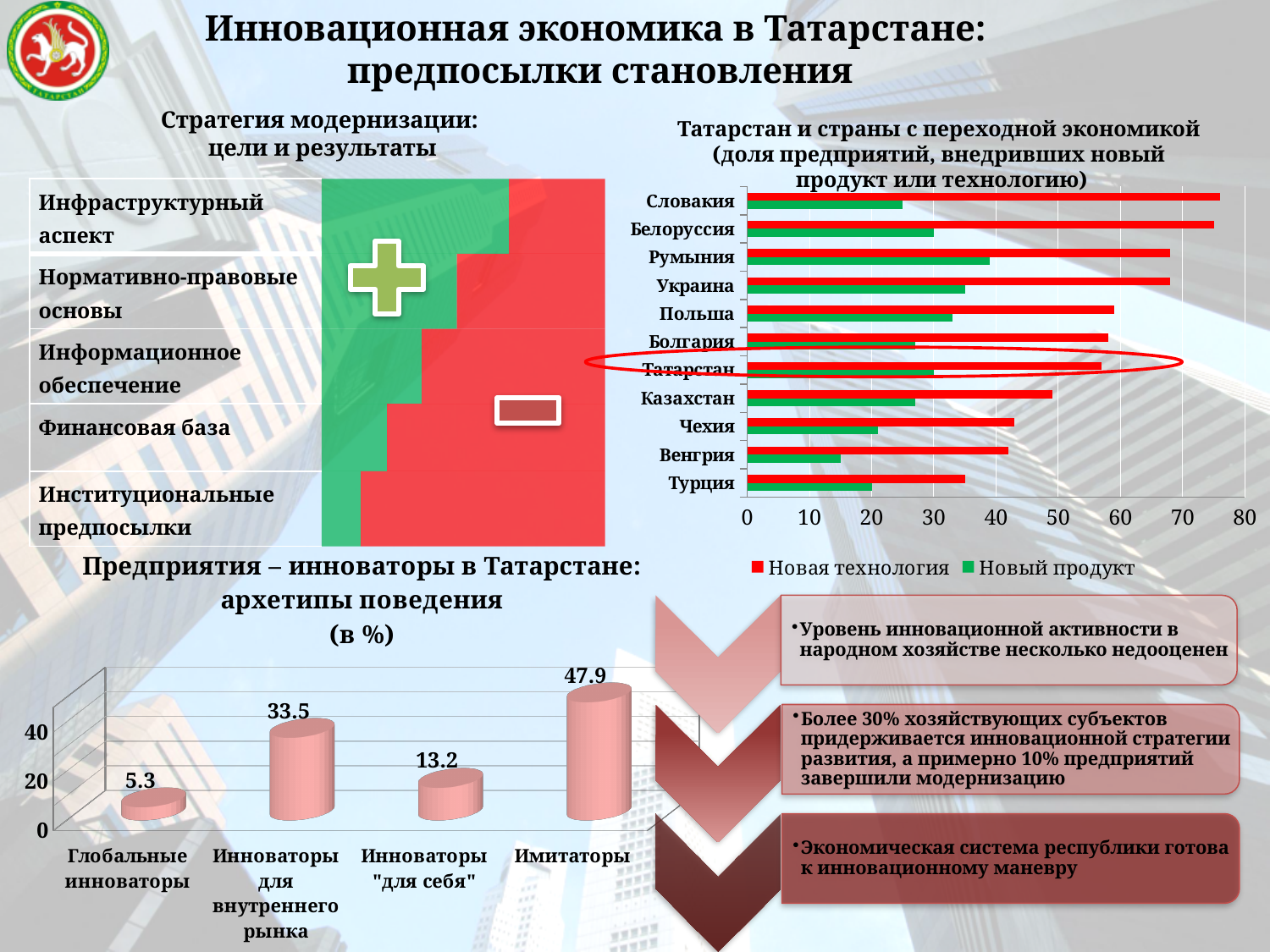
How many countries are shown in the chart 'Татарстан и страны с переходной экономикой'? 11 In the chart 'Татарстан и страны с переходной экономикой', which country has the lowest value for Новый продукт? Венгрия In the chart 'Предприятия – инноваторы в Татарстане: архетипы поведения (в %)', which category has the highest value? Имитаторы What kind of chart is 'Предприятия – инноваторы в Татарстане: архетипы поведения (в %)'? Bar chart In the chart 'Предприятия – инноваторы в Татарстане: архетипы поведения (в %)', what is the value for Инноваторы для внутреннего рынка? 33.5 In the chart 'Предприятия – инноваторы в Татарстане: архетипы поведения (в %)', which is larger: Инноваторы "для себя" or Глобальные инноваторы? Инноваторы "для себя" In the chart 'Предприятия – инноваторы в Татарстане: архетипы поведения (в %)', what is the difference between the values for Имитаторы and Инноваторы для внутреннего рынка? 14.4 How many series does the legend list in the chart 'Татарстан и страны с переходной экономикой'? 2 In the chart 'Татарстан и страны с переходной экономикой', is the value of Новая технология for Словакия greater or less than 70? greater How many categories are shown in the chart 'Предприятия – инноваторы в Татарстане: архетипы поведения (в %)'? 4 In the chart 'Предприятия – инноваторы в Татарстане: архетипы поведения (в %)', what is the value for Имитаторы? 47.9 In the chart 'Предприятия – инноваторы в Татарстане: архетипы поведения (в %)', which category has the lowest value? Глобальные инноваторы